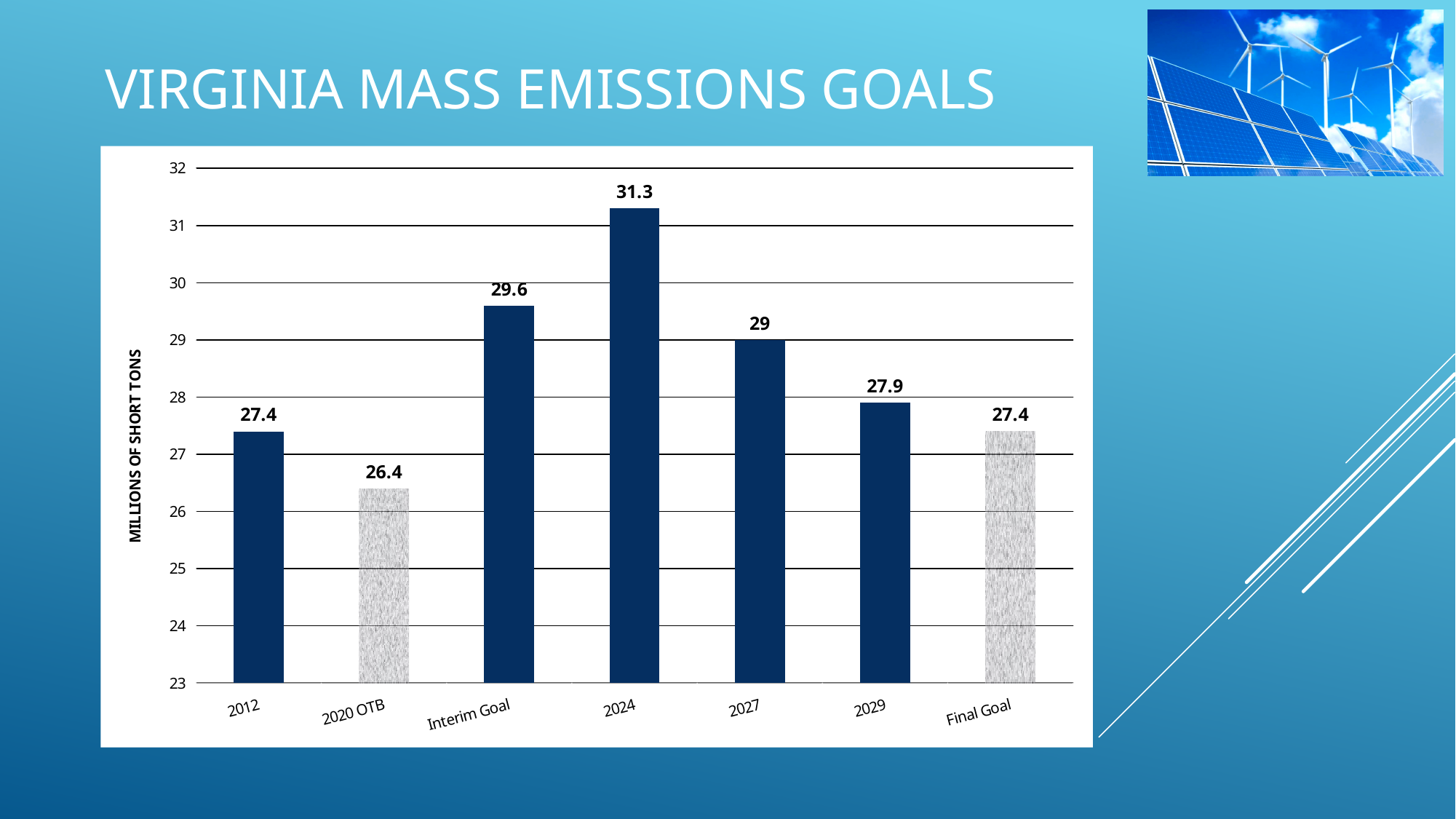
Do the values rise or fall from 2024 to 2029? Fall What is the difference between the values for 2024 and 2027? 2.3 What is the label on the vertical axis? Millions of Short Tons What is the value for the Final Goal? 27.4 What kind of chart is shown on the slide? Bar chart What is the value for 2020 OTB? 26.4 Which category has the lowest value? 2020 OTB What is the value for the Interim Goal? 29.6 What is the value for 2024? 31.3 Which is larger, the value for 2029 or the value for the Interim Goal? Interim Goal How many categories are shown on the x axis? 7 Which category has the highest value? 2024